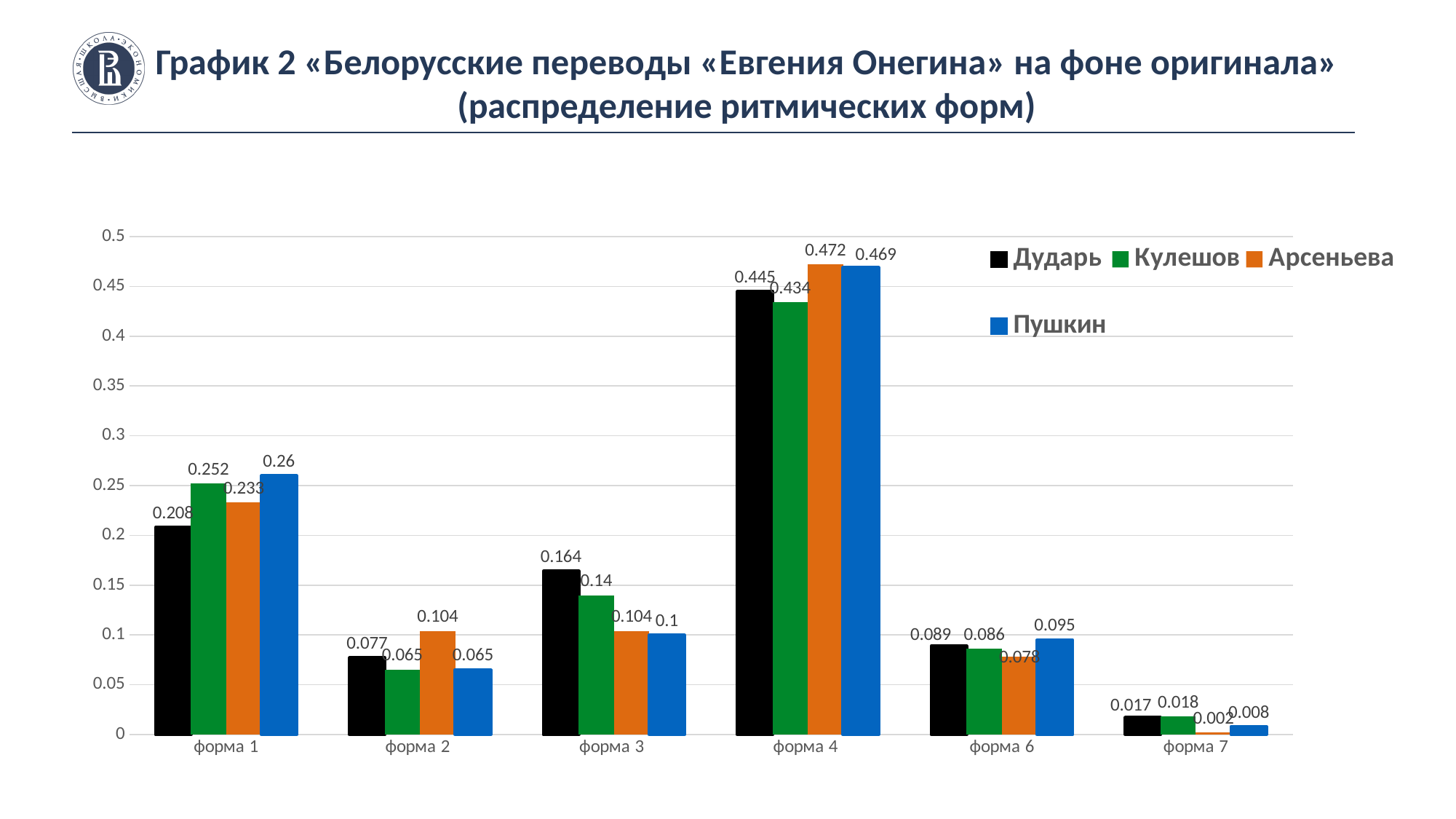
What is the value for Дударь at форма 3? 0.164 Which category has the highest value for the Пушкин series? форма 4 What is the value for Кулешов at форма 7? 0.018 What is the value for Арсеньева at форма 2? 0.104 What is the value for Пушкин at форма 4? 0.469 Which category has the lowest value for the Арсеньева series? форма 7 How many categories are shown on the x axis? 6 What is the difference between the Пушкин and Дударь values at форма 1? 0.052 Is the value for Арсеньева at форма 4 greater or less than 0.45? greater What kind of chart is shown on the slide? bar chart How many series does the legend list? 4 Which is larger at форма 3: the value for Дударь or the value for Кулешов? Дударь